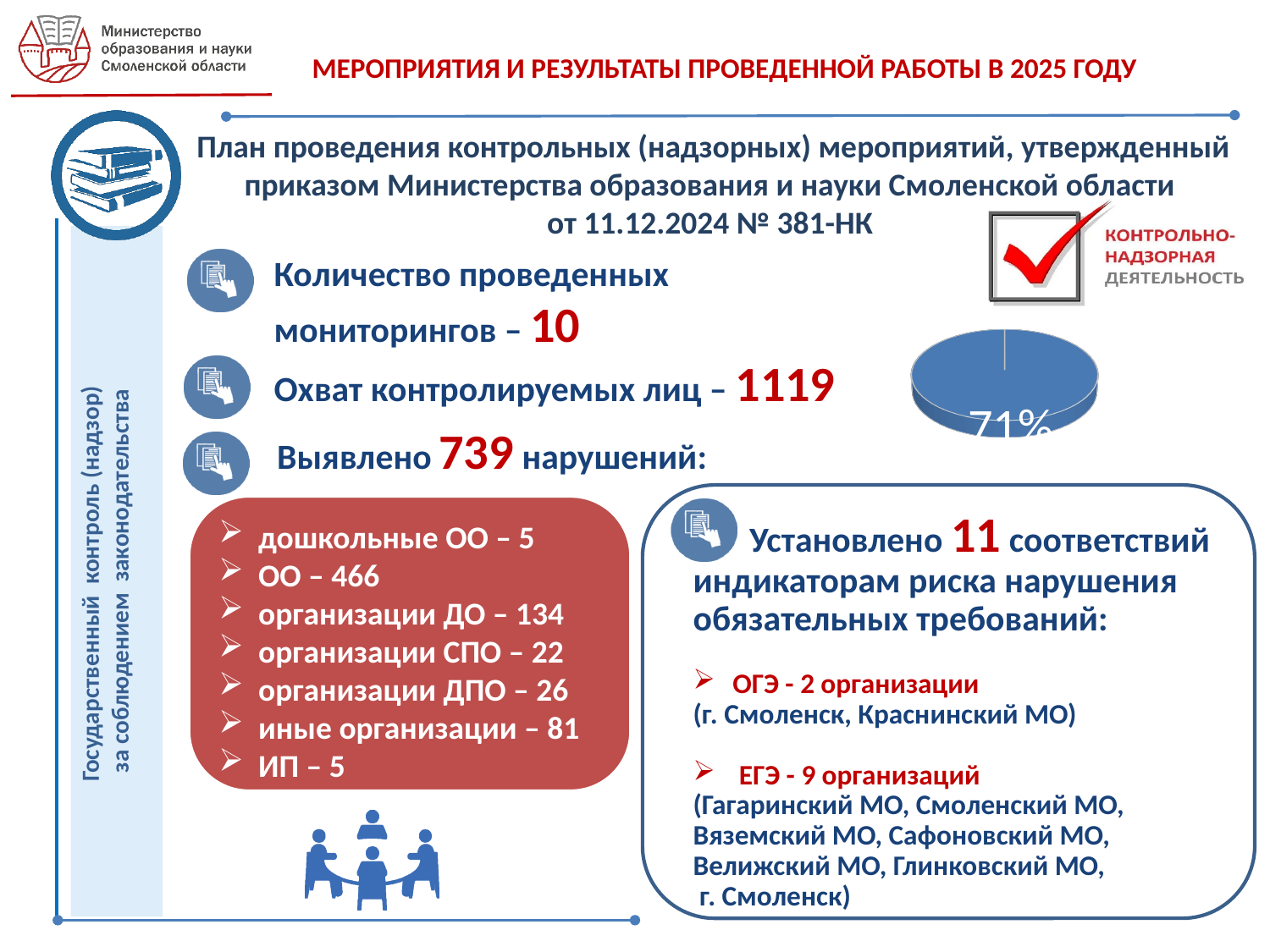
What percentage value is printed on the pie chart? 71% What kind of chart is shown on the right side of the slide, below the 'КОНТРОЛЬНО-НАДЗОРНАЯ ДЕЯТЕЛЬНОСТЬ' image? pie chart What colour is the pie chart on the slide? blue Is the share shown by the labelled slice of the pie chart greater or less than 50%? greater